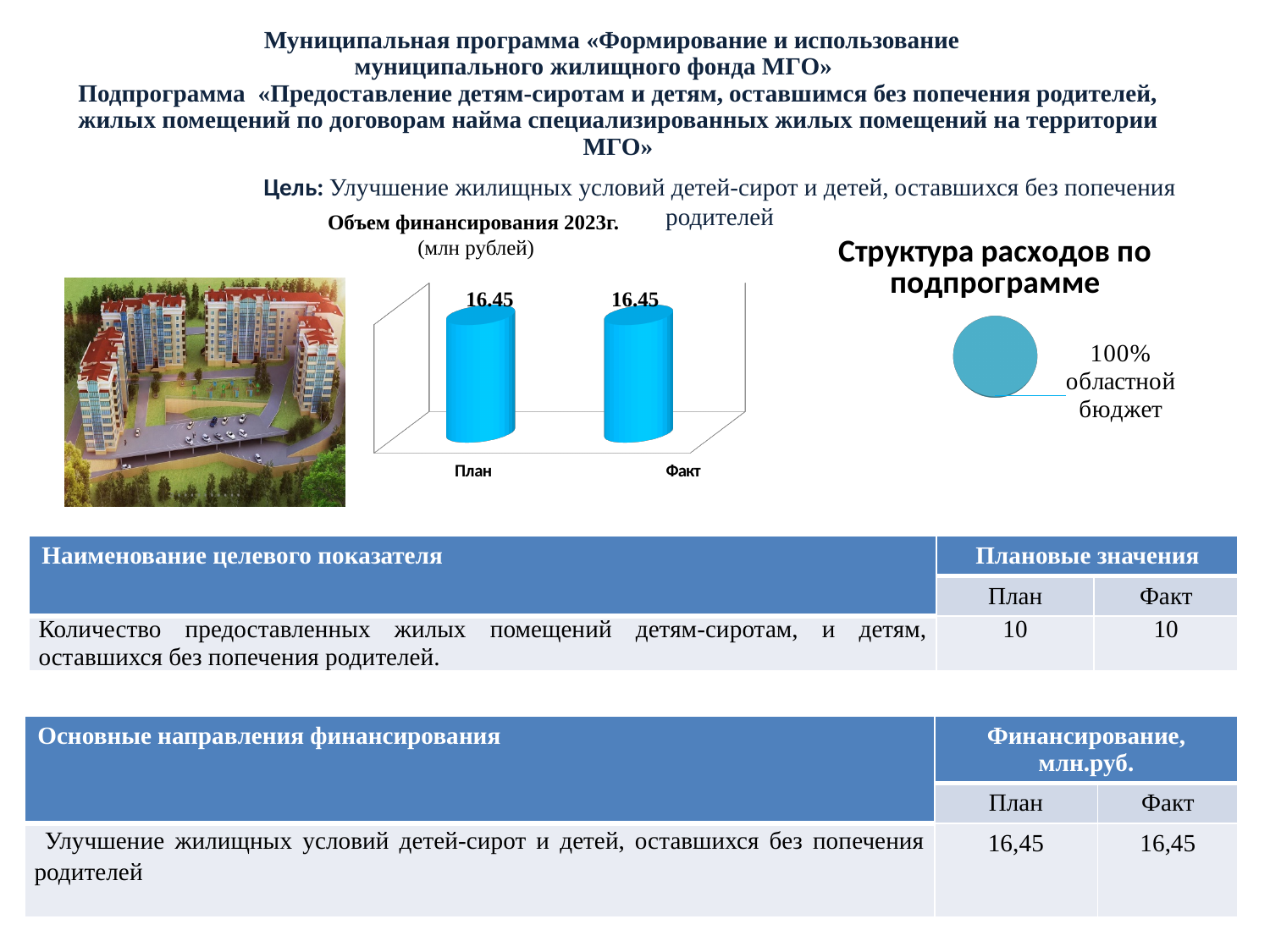
In the chart titled "Объем финансирования 2023г.", what is the difference between the План and Факт values? 0 What kind of chart is the one titled "Объем финансирования 2023г."? Bar chart In the chart titled "Объем финансирования 2023г.", what unit is given under the title? млн рублей In the chart titled "Объем финансирования 2023г.", what is the value for План? 16.45 In the chart titled "Структура расходов по подпрограмме", how many slices does the pie have? 1 In the chart titled "Объем финансирования 2023г.", what are the two category labels on the x axis? План and Факт In the chart titled "Структура расходов по подпрограмме", what share of the pie is областной бюджет? 100% In the chart titled "Объем финансирования 2023г.", how many categories are shown on the x axis? 2 In the chart titled "Объем финансирования 2023г.", what is the value for Факт? 16.45 What kind of chart is the one titled "Структура расходов по подпрограмме"? Pie chart In the chart titled "Структура расходов по подпрограмме", what is the label of the only slice? областной бюджет